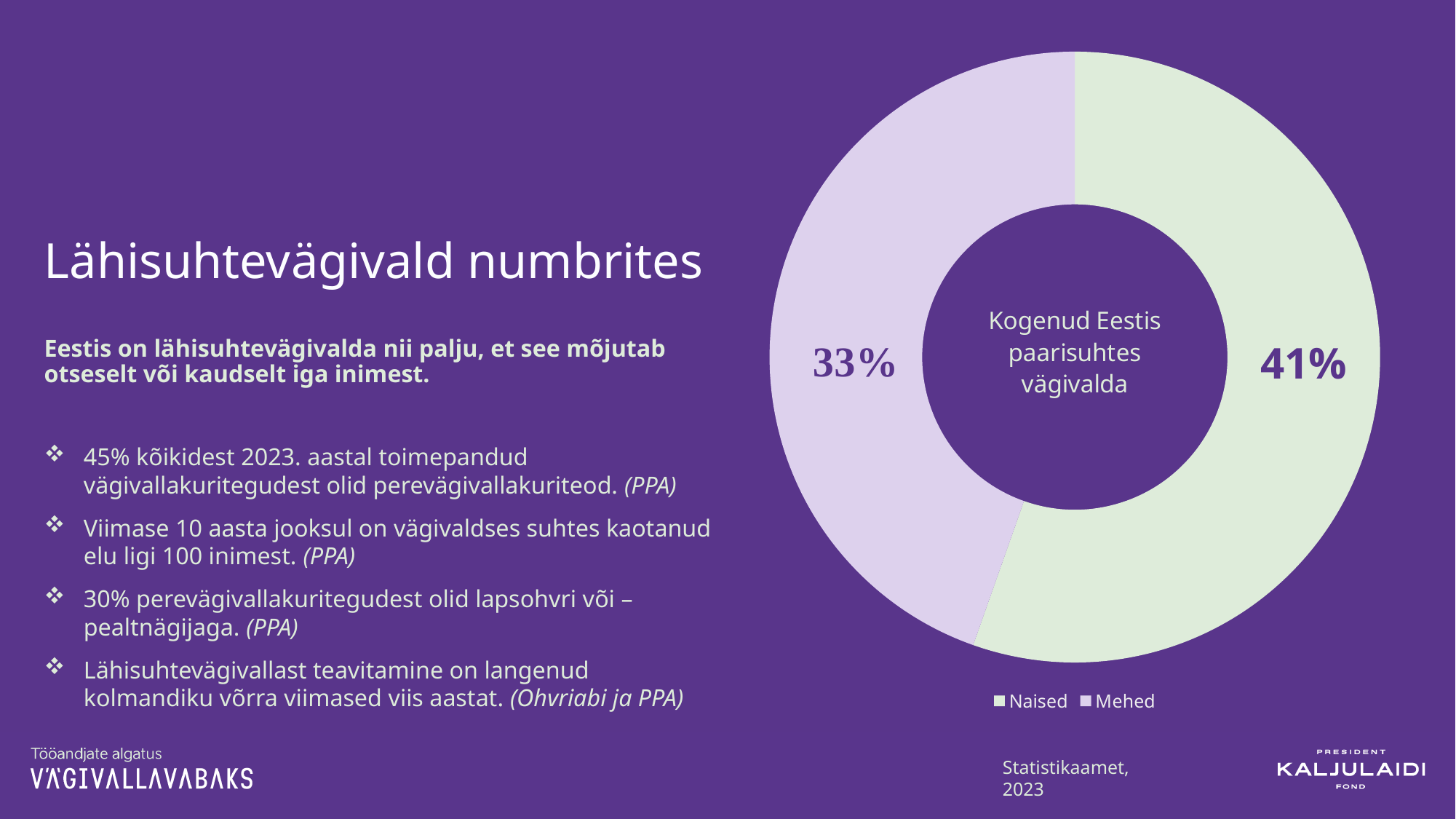
What is the value shown for Naised in the chart? 41% Which colour represents Naised in the chart? Light green What is the value shown for Mehed in the chart? 33% How many categories does the chart show? 2 Which category has the highest value in the chart? Naised How many entries does the chart legend list? 2 What text is written in the centre of the doughnut chart? Kogenud Eestis paarisuhtes vägivalda Which category has the higher value in the chart, Naised or Mehed? Naised What kind of chart is shown on the slide? Doughnut chart What is the difference between the values for Naised and Mehed in the chart? 8 percentage points Which category has the lowest value in the chart? Mehed